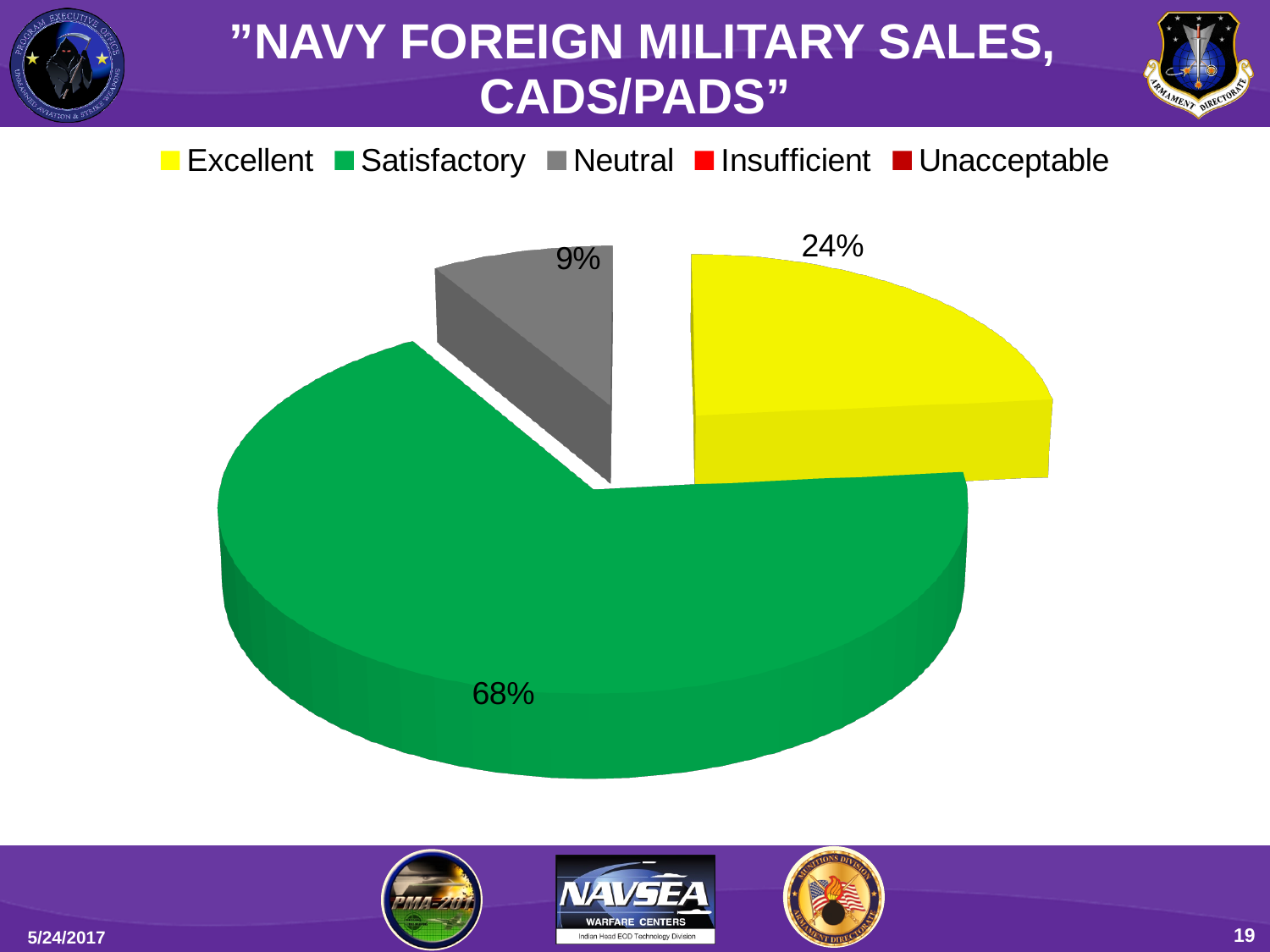
What colour is the Satisfactory slice? green How many slices are visible in the pie? 3 What share of the pie is labelled Neutral? 9% What is the difference in percentage points between the Excellent and Neutral slices? 15 What share of the pie is labelled Excellent? 24% Which category has the largest slice of the pie? Satisfactory How many categories does the legend list? 5 What share of the pie is labelled Satisfactory? 68% What kind of chart is shown on the slide? pie chart Which slice is larger, Excellent or Neutral? Excellent Which of the visible slices is the smallest? Neutral What is the difference in percentage points between the Satisfactory and Excellent slices? 44